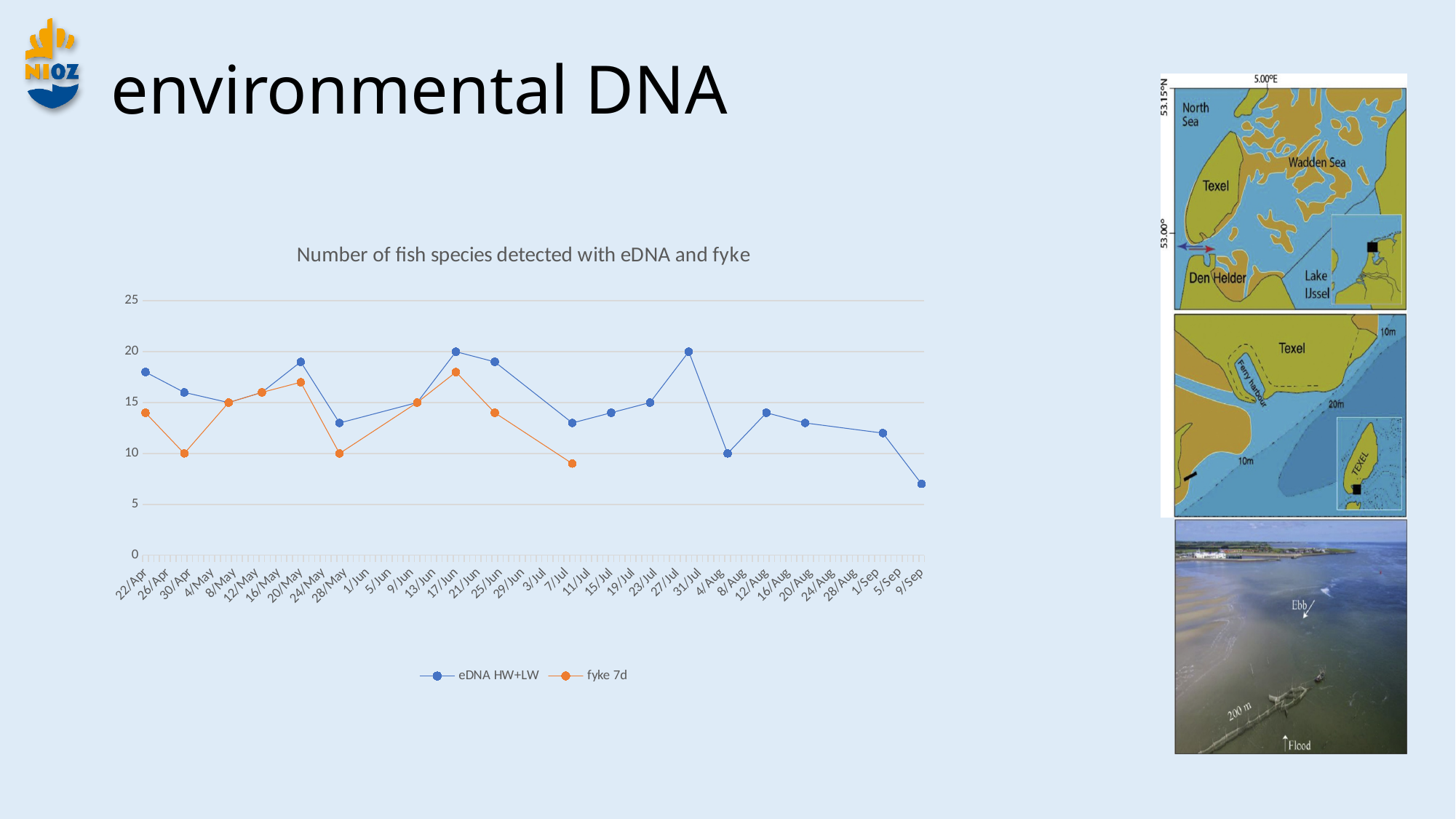
What are the two series named in the chart legend? eDNA HW+LW and fyke 7d How many series does the legend of the chart list? 2 On which date does the fyke 7d series reach its highest value? 17/Jun Is the eDNA HW+LW value on 22/Apr greater or less than 15? greater How many data points are plotted for the fyke 7d series? 10 What is the title of the chart? Number of fish species detected with eDNA and fyke On which date is the eDNA HW+LW value lowest? 9/Sep What kind of chart is shown on the slide? line chart What is the highest value reached by the eDNA HW+LW series? 20 On 22/Apr, which series has the larger value, eDNA HW+LW or fyke 7d? eDNA HW+LW Is the eDNA HW+LW value on 9/Sep greater or less than 10? less